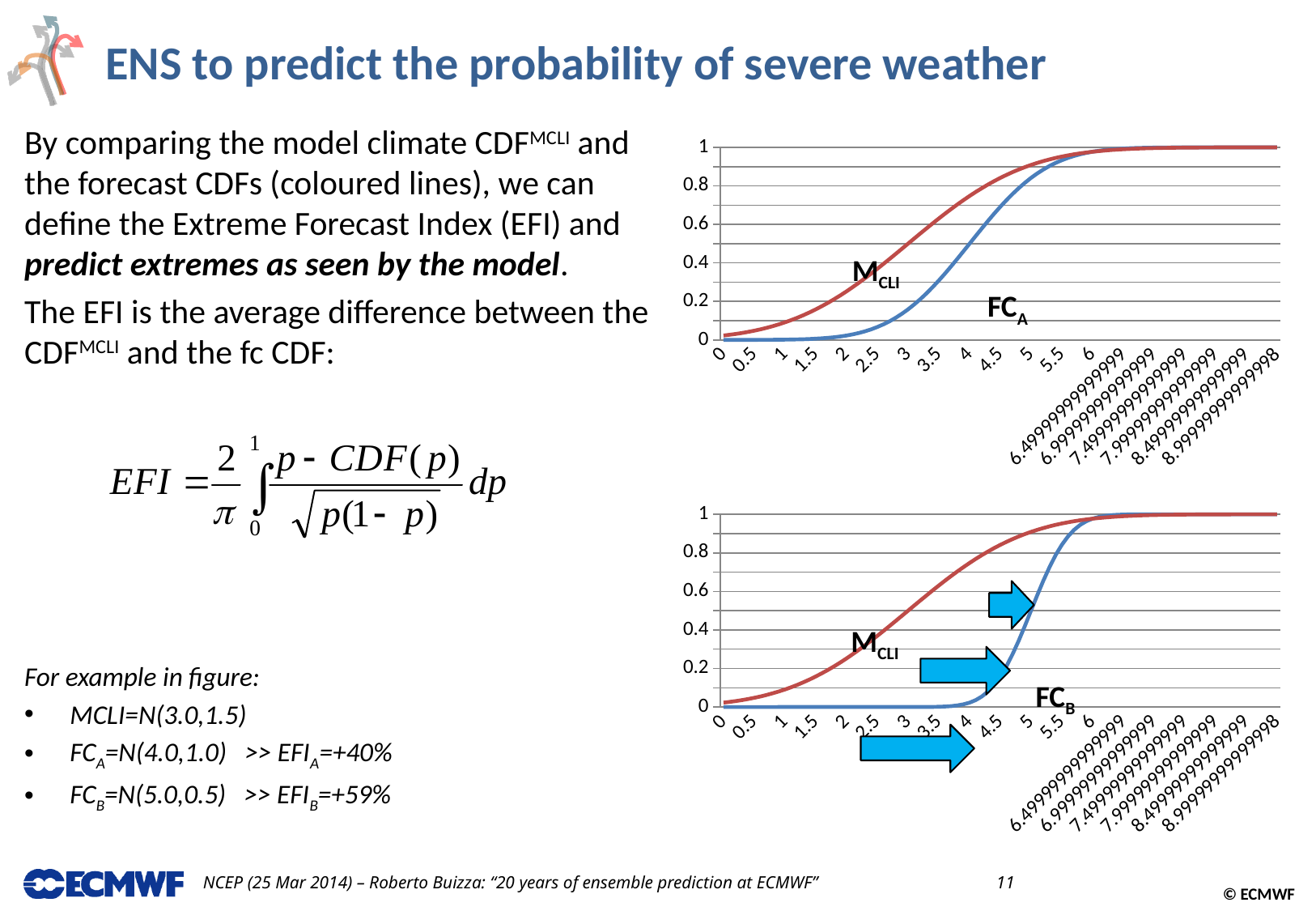
How many curves are plotted in the bottom chart? 2 In the top chart, do the curves rise or fall as x increases? rise In the top chart, is the value of the FC_A curve at x = 2 greater or less than 0.2? less In the bottom chart, is the value of the FC_B curve at x = 6 greater or less than 0.8? greater In the bottom chart, is the value of the M_CLI curve at x = 5 greater or less than 0.8? greater In the top chart, at x = 4, which curve has the higher value, M_CLI or FC_A? M_CLI What kind of chart is the top chart on the slide? line chart In the bottom chart, at x = 5, which curve has the higher value, M_CLI or FC_B? M_CLI In the bottom chart, what is the label of the blue curve? FC_B In the top chart, what is the label of the blue curve? FC_A